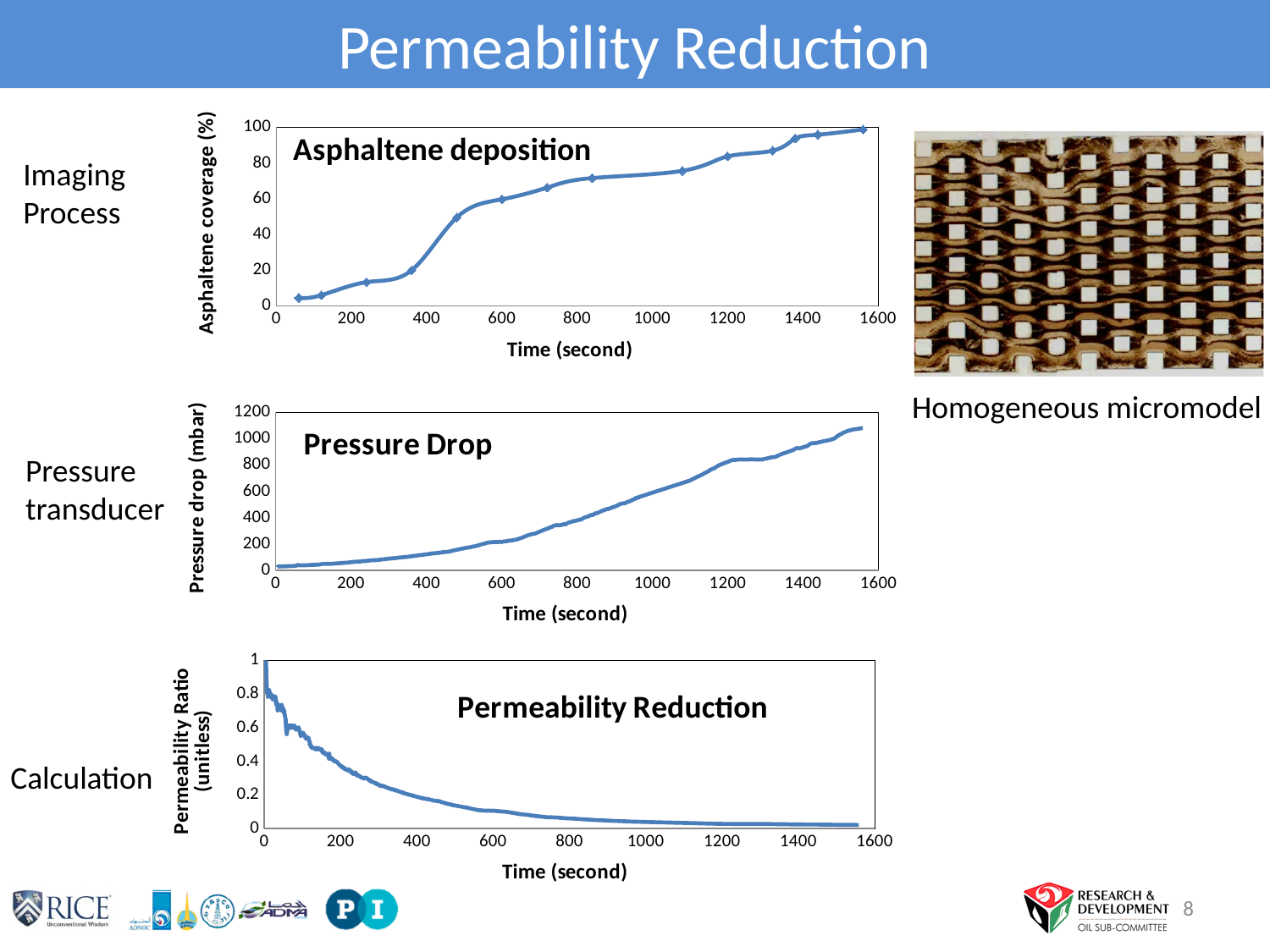
In the Asphaltene deposition chart, is the asphaltene coverage at 1200 seconds greater or less than 60? greater In the Asphaltene deposition chart, is the highest asphaltene coverage value greater or less than 80? greater In the Pressure Drop chart, is the pressure drop at 400 seconds greater or less than 400? less In the Asphaltene deposition chart, do the values rise or fall as time increases? rise How many charts are shown on the slide? 3 In the Permeability Reduction chart, do the values rise or fall as time increases? fall In the Pressure Drop chart, do the values rise or fall as time increases? rise What kind of chart is the Asphaltene deposition chart? line chart What is the y-axis title of the Pressure Drop chart? Pressure drop (mbar)